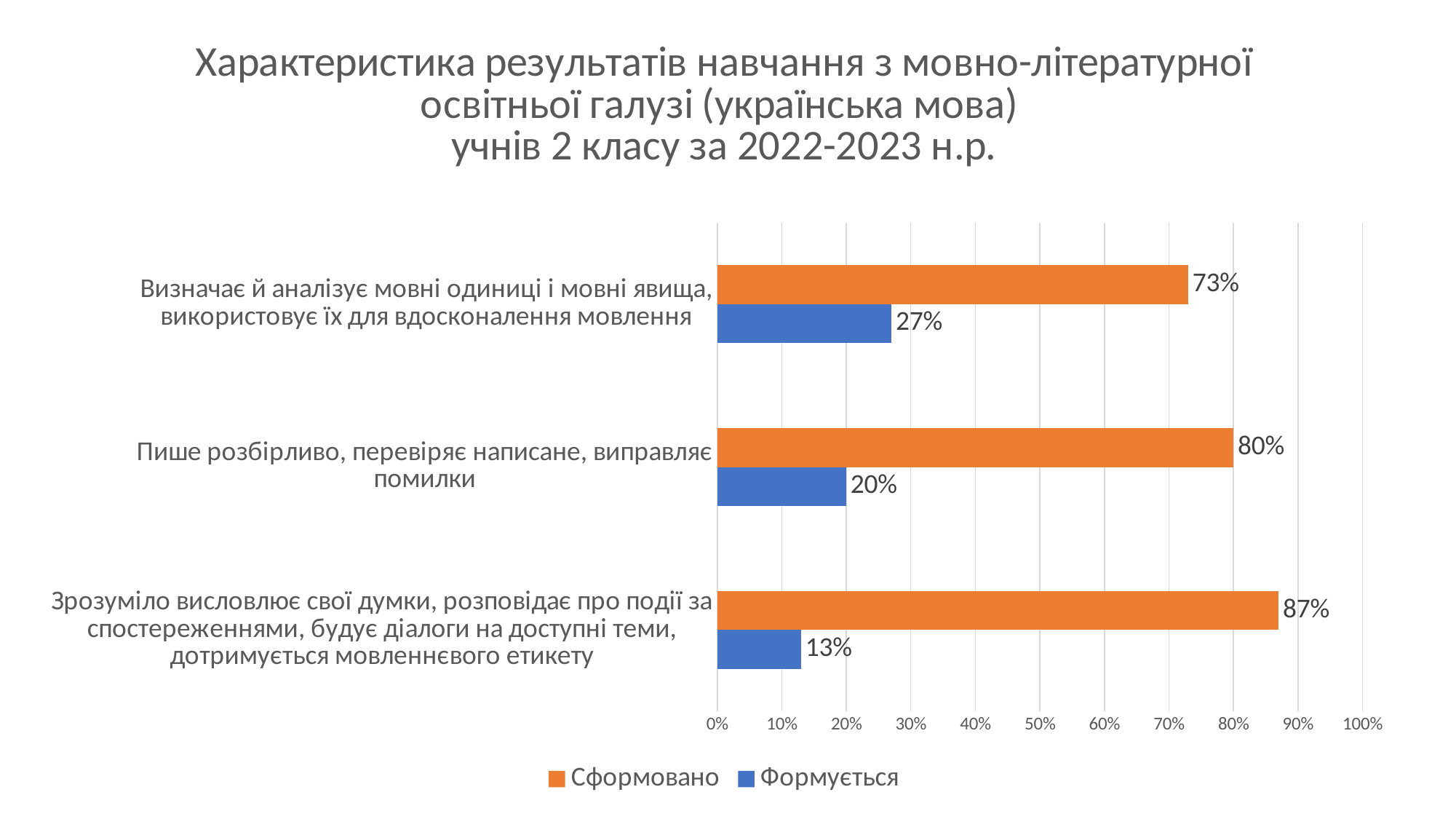
What is the 'Сформовано' value for 'Пише розбірливо, перевіряє написане, виправляє помилки'? 80% How many categories are shown on the chart? 3 Is the 'Сформовано' value for 'Визначає й аналізує мовні одиниці і мовні явища, використовує їх для вдосконалення мовлення' greater or less than 70%? greater What is the 'Формується' value for 'Визначає й аналізує мовні одиниці і мовні явища, використовує їх для вдосконалення мовлення'? 27% Which is larger: the 'Сформовано' value for 'Визначає й аналізує мовні одиниці і мовні явища, використовує їх для вдосконалення мовлення' or the 'Сформовано' value for 'Пише розбірливо, перевіряє написане, виправляє помилки'? Пише розбірливо, перевіряє написане, виправляє помилки What is the 'Формується' value for 'Зрозуміло висловлює свої думки, розповідає про події за спостереженнями, будує діалоги на доступні теми, дотримується мовленнєвого етикету'? 13% Which category has the lowest 'Формується' value? Зрозуміло висловлює свої думки, розповідає про події за спостереженнями, будує діалоги на доступні теми, дотримується мовленнєвого етикету What kind of chart is shown on the slide? Bar chart How many series does the legend list? 2 Which colour represents the 'Формується' series? Blue Which category has the highest 'Сформовано' value? Зрозуміло висловлює свої думки, розповідає про події за спостереженнями, будує діалоги на доступні теми, дотримується мовленнєвого етикету What is the difference between the 'Сформовано' and 'Формується' values for 'Пише розбірливо, перевіряє написане, виправляє помилки'? 60%